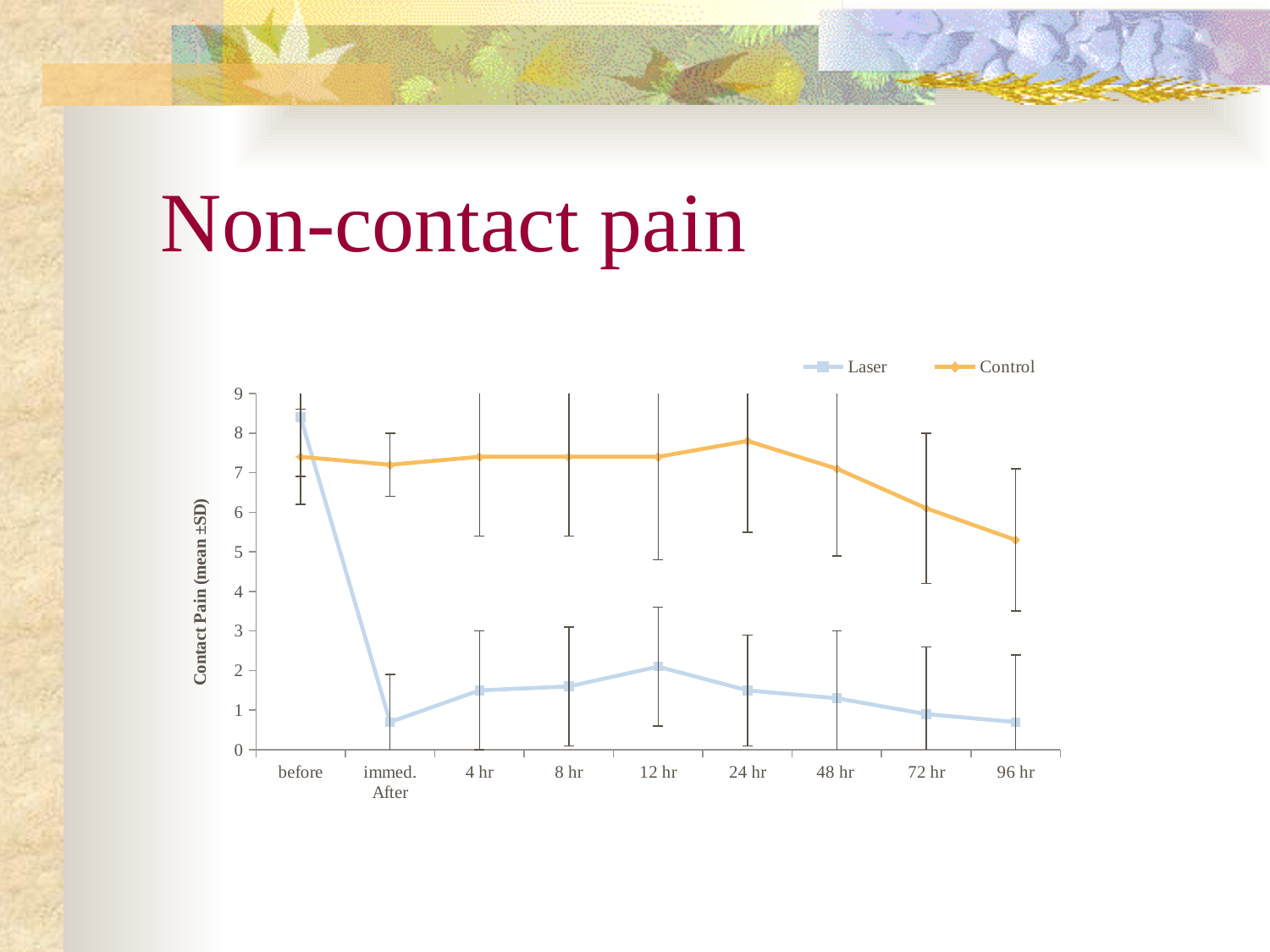
What is the label on the y axis? Contact Pain (mean ±SD) What kind of chart is shown on the slide? line chart Is the Laser value at immed. After greater or less than 2? less Does the Control series rise or fall from 24 hr to 96 hr? fall At which time point is the Control series lowest? 96 hr Is the Laser value at before greater or less than 8? greater How many time points are shown along the x axis? 9 At which time point is the Laser series highest? before Is the Control value at 96 hr greater or less than 5? greater How many series does the legend list? 2 At which time point is the Control series highest? 24 hr At 24 hr, which series has the larger value, Laser or Control? Control